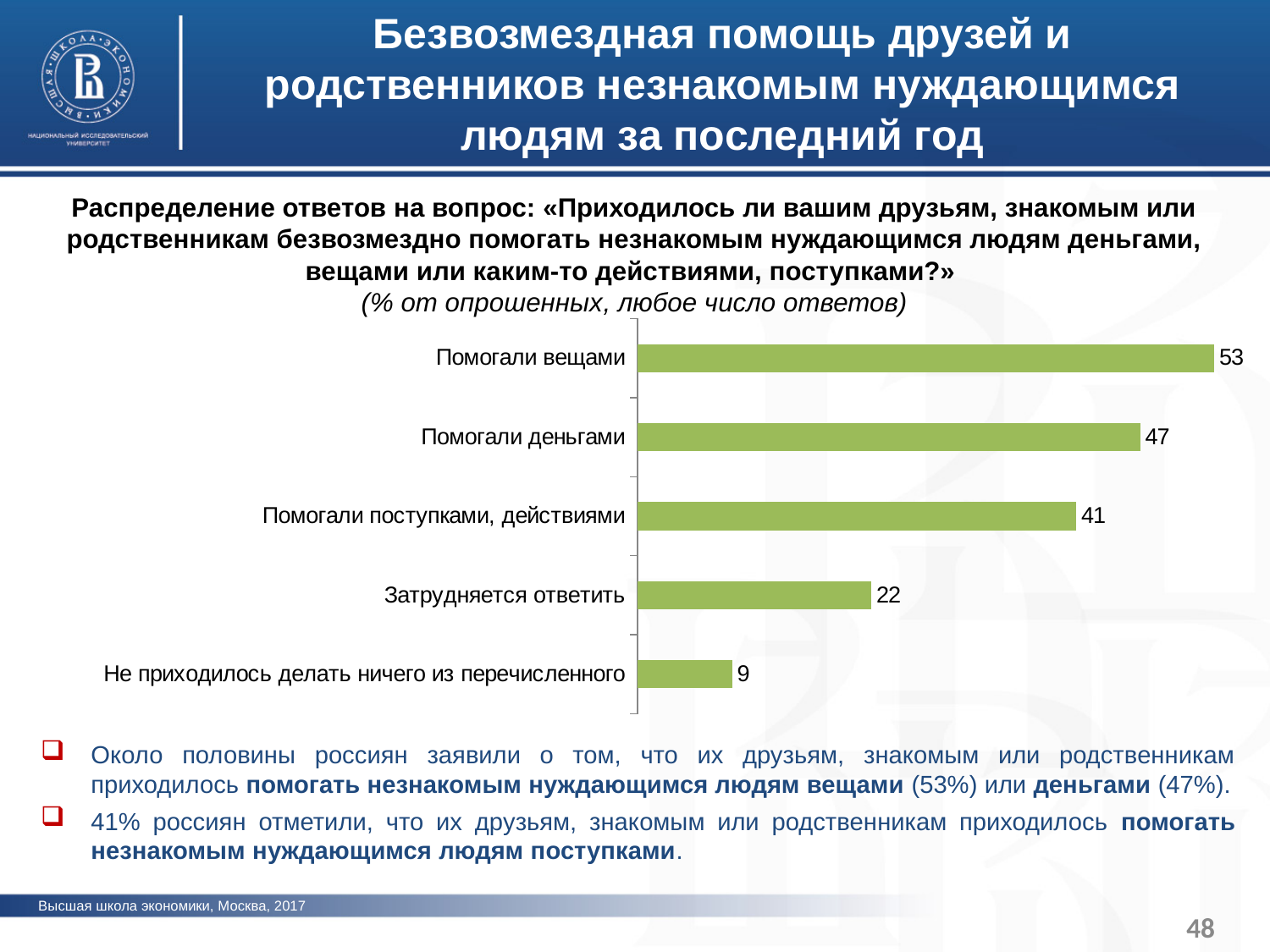
What is the difference between the values for «Помогали поступками, действиями» and «Затрудняется ответить»? 19 What is the value for «Не приходилось делать ничего из перечисленного»? 9 What is the value for «Помогали деньгами»? 47 What kind of chart is shown on the slide? Bar chart What is the difference between the values for «Помогали вещами» and «Помогали деньгами»? 6 What is the value for «Помогали вещами»? 53 Which category has the highest value? Помогали вещами How many categories are shown in the chart? 5 What is the value for «Помогали поступками, действиями»? 41 Which is larger: the value for «Помогали деньгами» or for «Помогали поступками, действиями»? Помогали деньгами Which category has the lowest value? Не приходилось делать ничего из перечисленного What is the value for «Затрудняется ответить»? 22